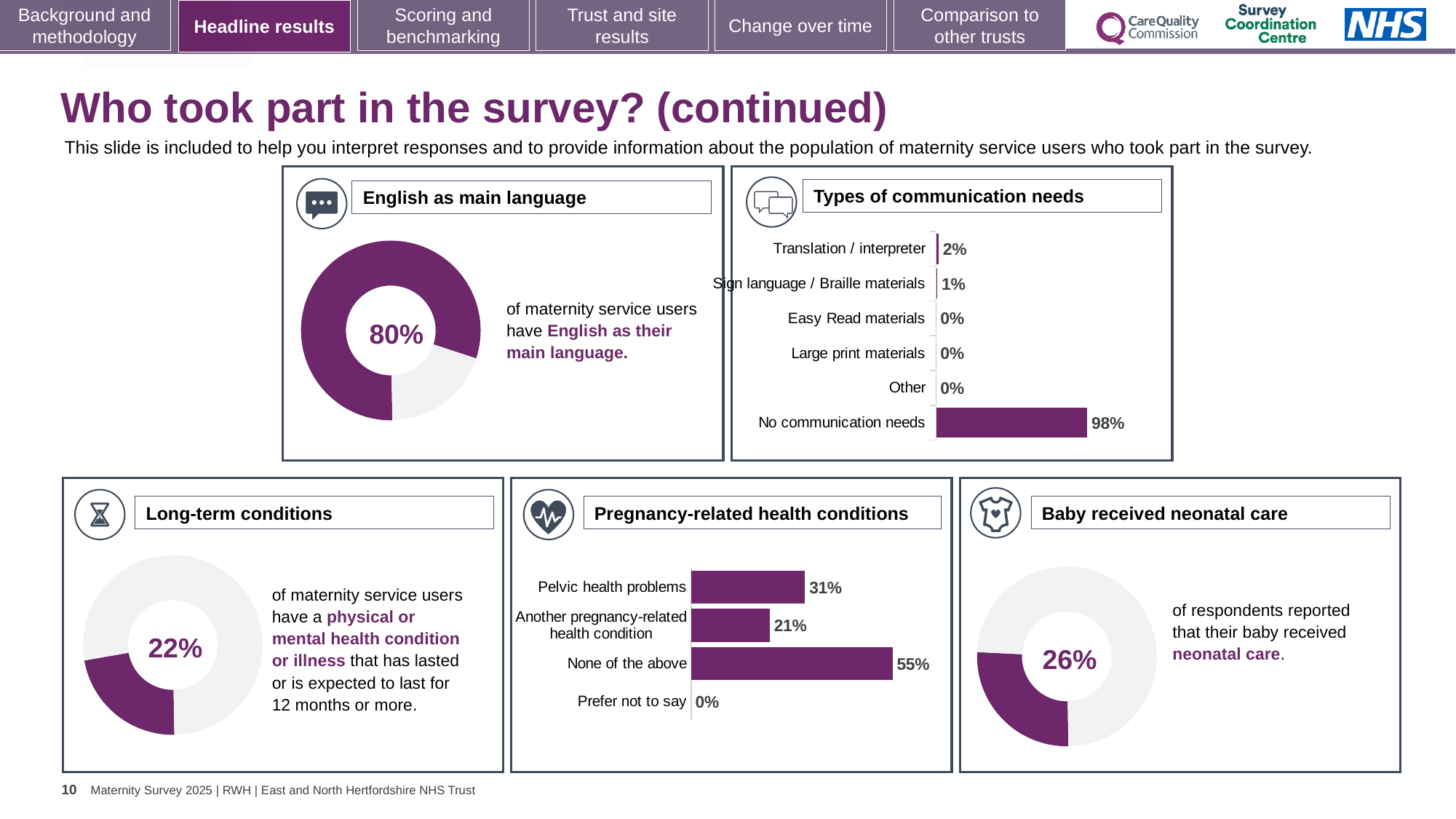
In the 'Types of communication needs' chart, what is the value for 'Translation / interpreter'? 2% How many categories are shown in the 'Types of communication needs' chart? 6 What percentage is shown in the 'Baby received neonatal care' donut chart? 26% In the 'Pregnancy-related health conditions' chart, what is the difference between 'None of the above' and 'Another pregnancy-related health condition'? 34% In the 'Pregnancy-related health conditions' chart, which category has the lowest value? Prefer not to say What percentage is shown in the 'English as main language' donut chart? 80% In the 'Pregnancy-related health conditions' chart, what is the value for 'None of the above'? 55% In the 'Pregnancy-related health conditions' chart, which is larger: 'Pelvic health problems' or 'Another pregnancy-related health condition'? Pelvic health problems In the 'Pregnancy-related health conditions' chart, what is the value for 'Pelvic health problems'? 31% In the 'Types of communication needs' chart, what is the value for 'No communication needs'? 98% In the 'Types of communication needs' chart, which category has the highest value? No communication needs What kind of chart is the 'Types of communication needs' chart? Bar chart